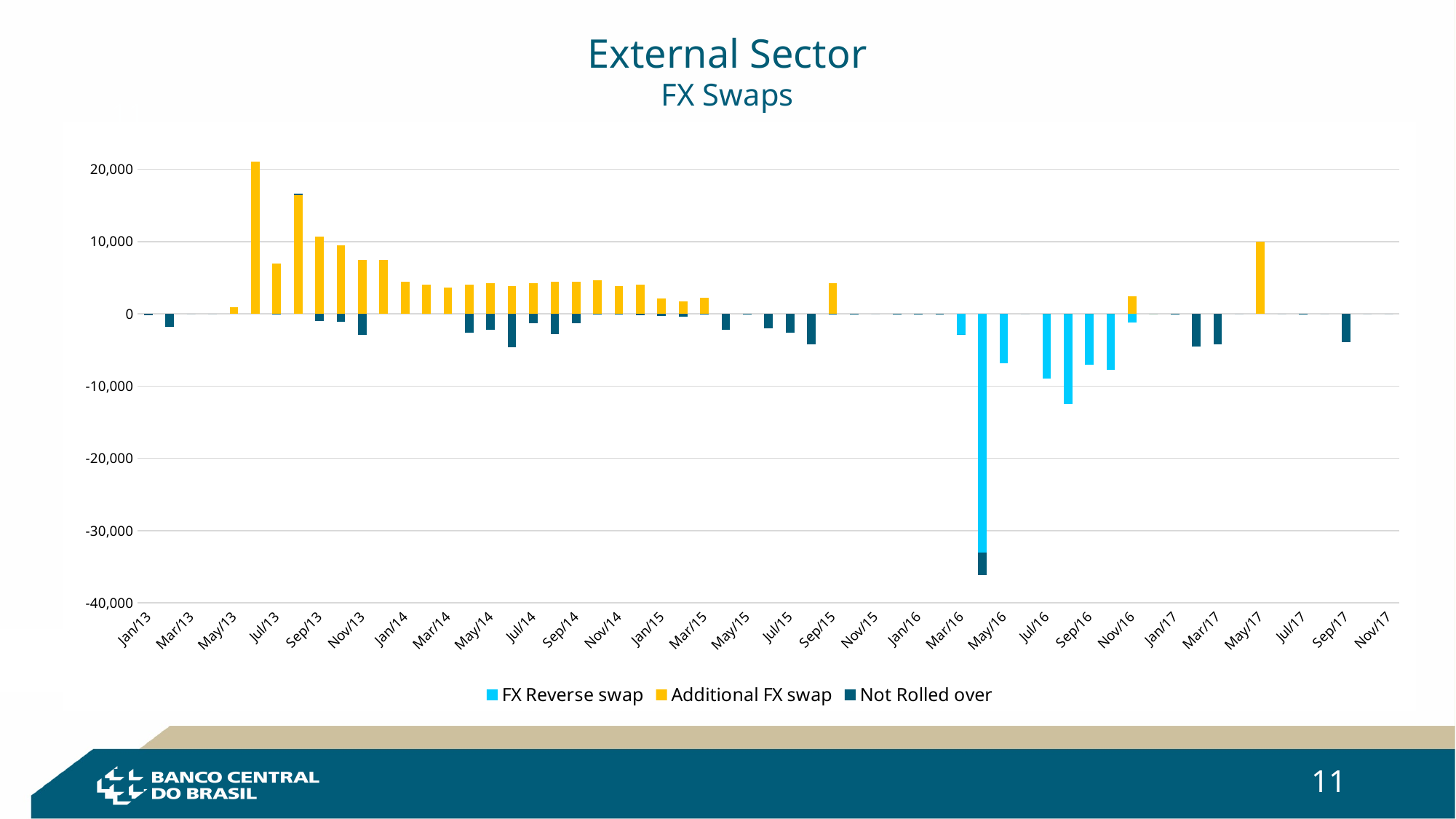
Is the Additional FX swap value for Sep/15 greater or less than 10,000? less Do the Additional FX swap bars generally rise or fall from Sep/13 through Mar/15? fall How many series does the legend list? 3 What kind of chart is shown on the slide? bar chart How many month labels are shown on the x axis? 30 Which series has the bar that reaches furthest below zero? FX Reverse swap What is the subtitle of the chart under 'External Sector'? FX Swaps Is the FX Reverse swap value for Sep/16 greater or less than -10,000? greater In which year does the bar reaching furthest below zero occur? 2016 What are the three series named in the legend? FX Reverse swap, Additional FX swap, Not Rolled over In which year does the tallest positive bar on the chart occur? 2013 Which month has the larger Additional FX swap bar, Jul/13 or Sep/13? Sep/13